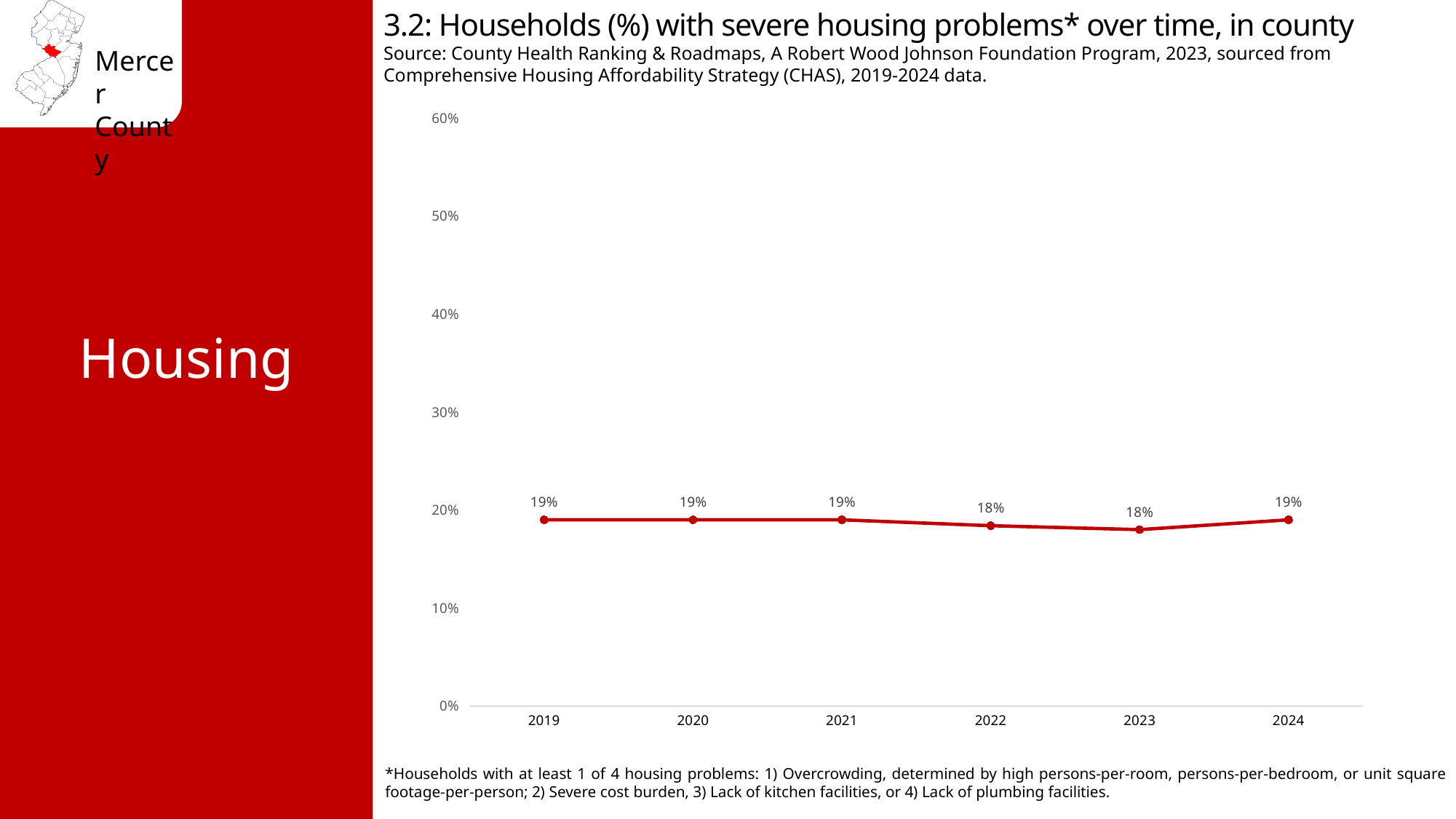
What is the difference between the values for 2021 and 2022? 1% What is the value for 2019? 19% Which of 2021 or 2022 has the larger value? 2021 What kind of chart is shown on the slide? line chart Is the value for 2023 greater or less than 10%? greater What is the highest value shown on the y axis? 60% What is the title of the chart? 3.2: Households (%) with severe housing problems* over time, in county What is the value for 2022? 18% What is the value for 2023? 18% Is the value for 2020 greater or less than 30%? less What is the value for 2024? 19% How many years are plotted on the x axis? 6